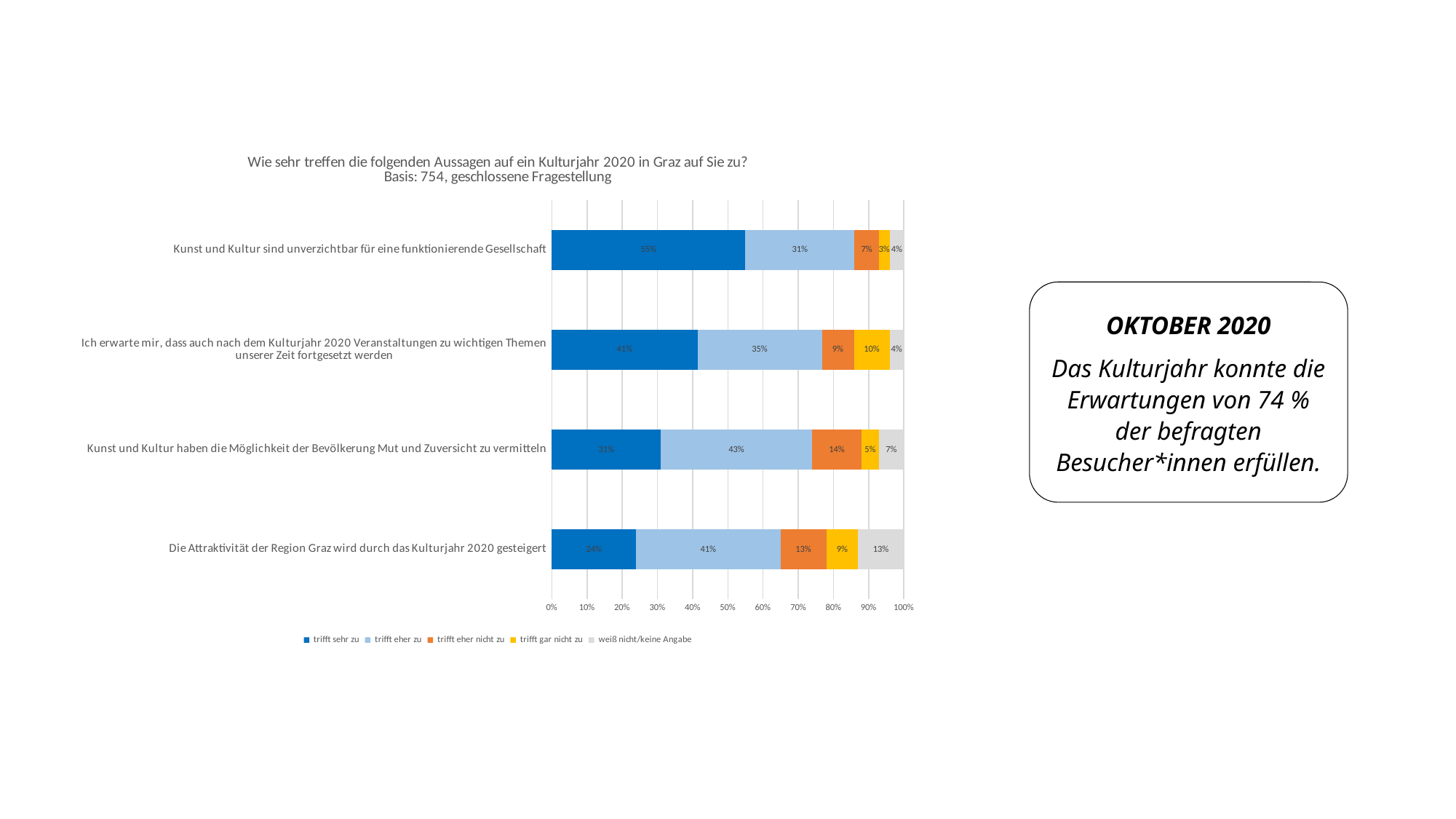
What is the 'weiß nicht/keine Angabe' value for 'Die Attraktivität der Region Graz wird durch das Kulturjahr 2020 gesteigert'? 13% What kind of chart is shown on the slide? Stacked bar chart What is the 'trifft eher zu' value for 'Kunst und Kultur haben die Möglichkeit der Bevölkerung Mut und Zuversicht zu vermitteln'? 43% How many statements (categories) are shown in the chart? 4 What is the 'trifft sehr zu' value for 'Kunst und Kultur sind unverzichtbar für eine funktionierende Gesellschaft'? 55% Which statement has the lowest 'trifft sehr zu' value? Die Attraktivität der Region Graz wird durch das Kulturjahr 2020 gesteigert Which statement has the highest 'trifft sehr zu' value? Kunst und Kultur sind unverzichtbar für eine funktionierende Gesellschaft What is the difference between the 'trifft sehr zu' values for 'Kunst und Kultur sind unverzichtbar für eine funktionierende Gesellschaft' and 'Die Attraktivität der Region Graz wird durch das Kulturjahr 2020 gesteigert'? 31% How many series does the legend list? 5 What is the combined share of 'trifft sehr zu' and 'trifft eher zu' for 'Die Attraktivität der Region Graz wird durch das Kulturjahr 2020 gesteigert'? 65% Which is larger: the 'trifft eher nicht zu' value for 'Kunst und Kultur haben die Möglichkeit der Bevölkerung Mut und Zuversicht zu vermitteln' or for 'Kunst und Kultur sind unverzichtbar für eine funktionierende Gesellschaft'? Kunst und Kultur haben die Möglichkeit der Bevölkerung Mut und Zuversicht zu vermitteln What is the 'trifft gar nicht zu' value for 'Ich erwarte mir, dass auch nach dem Kulturjahr 2020 Veranstaltungen zu wichtigen Themen unserer Zeit fortgesetzt werden'? 10%